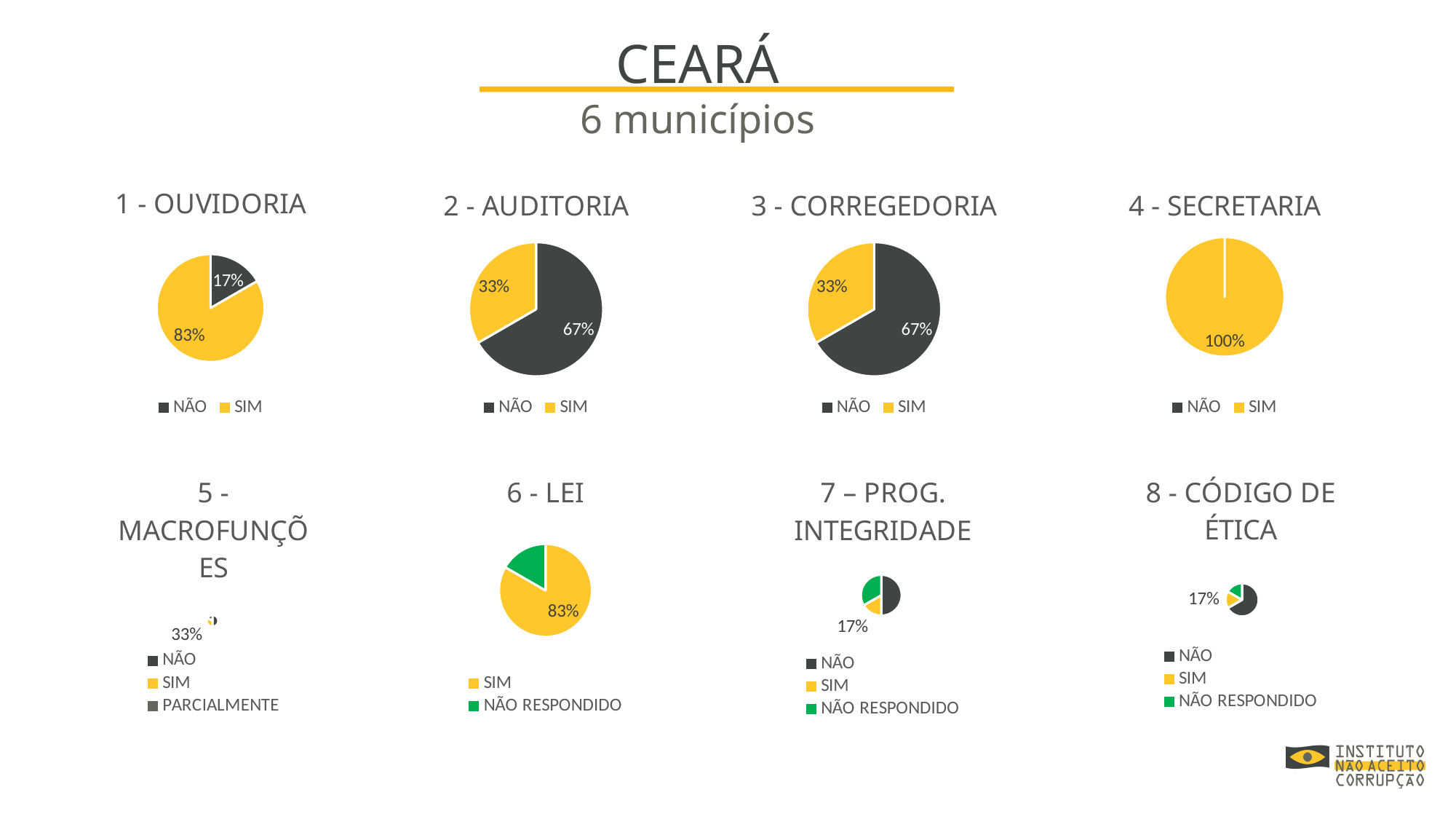
In the 2 - AUDITORIA pie chart, which slice is larger, NÃO or SIM? NÃO In the 3 - CORREGEDORIA pie chart, which slice is the largest? NÃO In the 1 - OUVIDORIA pie chart, what is the difference between the SIM and NÃO shares? 66% In the 2 - AUDITORIA pie chart, what share is labelled for NÃO? 67% In the 1 - OUVIDORIA pie chart, what share is labelled for SIM? 83% What type of chart is used for 4 - SECRETARIA? Pie chart In the 6 - LEI pie chart, what share is labelled for SIM? 83% What is the main title at the top of the slide? CEARÁ In the 1 - OUVIDORIA pie chart, what share is labelled for NÃO? 17% In the 4 - SECRETARIA pie chart, what share is labelled for SIM? 100% In the 3 - CORREGEDORIA pie chart, what share is labelled for SIM? 33% How many entries does the legend of the 7 – PROG. INTEGRIDADE chart list? 3